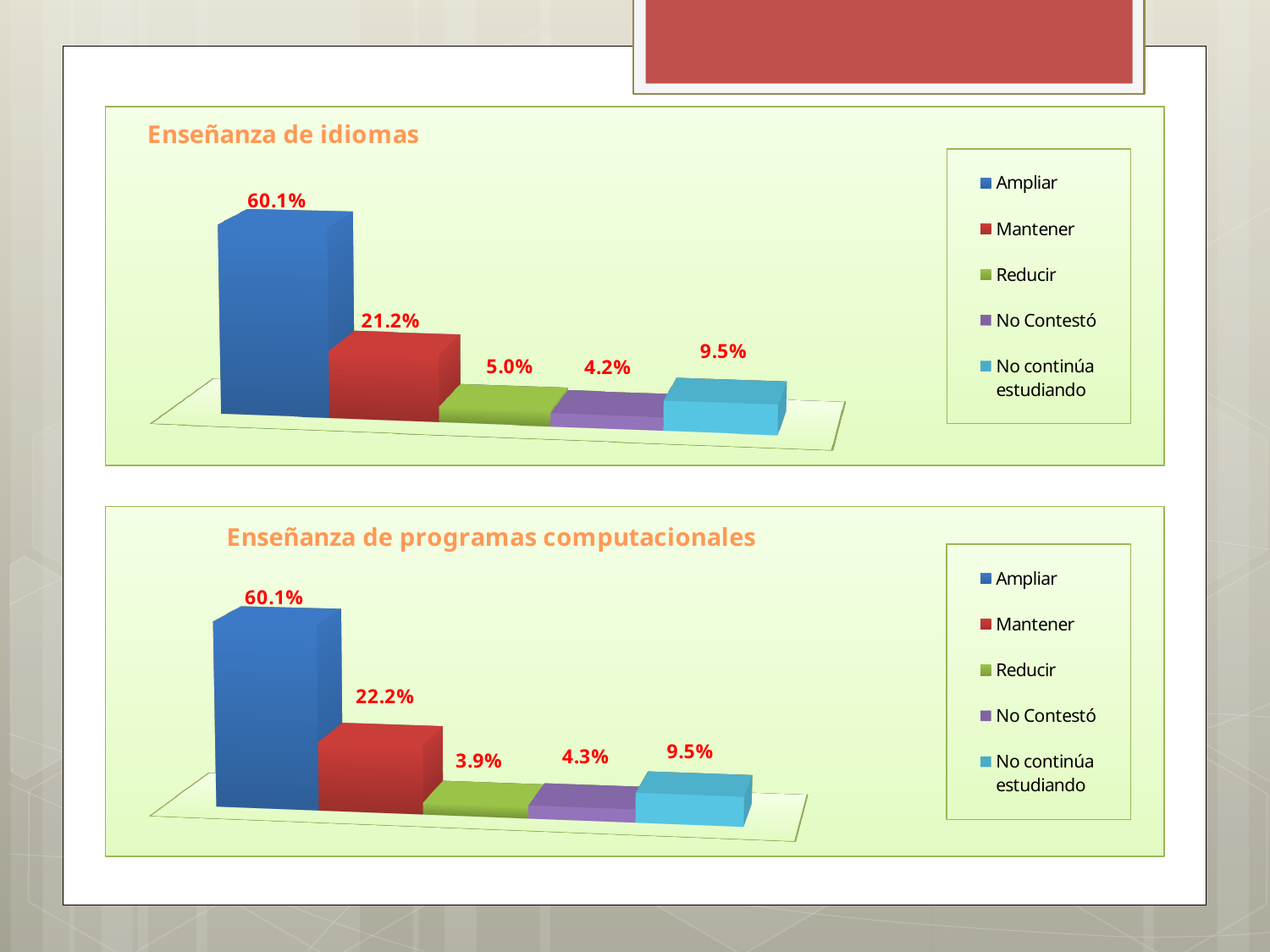
In the 'Enseñanza de programas computacionales' chart, which category has the highest value? Ampliar In the 'Enseñanza de idiomas' chart, what is the difference between Ampliar and Mantener? 38.9% How many entries does the legend of the 'Enseñanza de idiomas' chart list? 5 In the 'Enseñanza de programas computacionales' chart, what is the value for Mantener? 22.2% In the 'Enseñanza de idiomas' chart, which is larger, Reducir or No continúa estudiando? No continúa estudiando How many categories does the 'Enseñanza de programas computacionales' chart show? 5 What kind of chart is the 'Enseñanza de idiomas' chart? Bar chart In the 'Enseñanza de programas computacionales' chart, what is the value for Reducir? 3.9% In the 'Enseñanza de programas computacionales' chart, what is the difference between No continúa estudiando and No Contestó? 5.2% In the 'Enseñanza de idiomas' chart, what is the value for Ampliar? 60.1% In the 'Enseñanza de idiomas' chart, which category has the lowest value? No Contestó In the 'Enseñanza de idiomas' chart, what is the value for Mantener? 21.2%